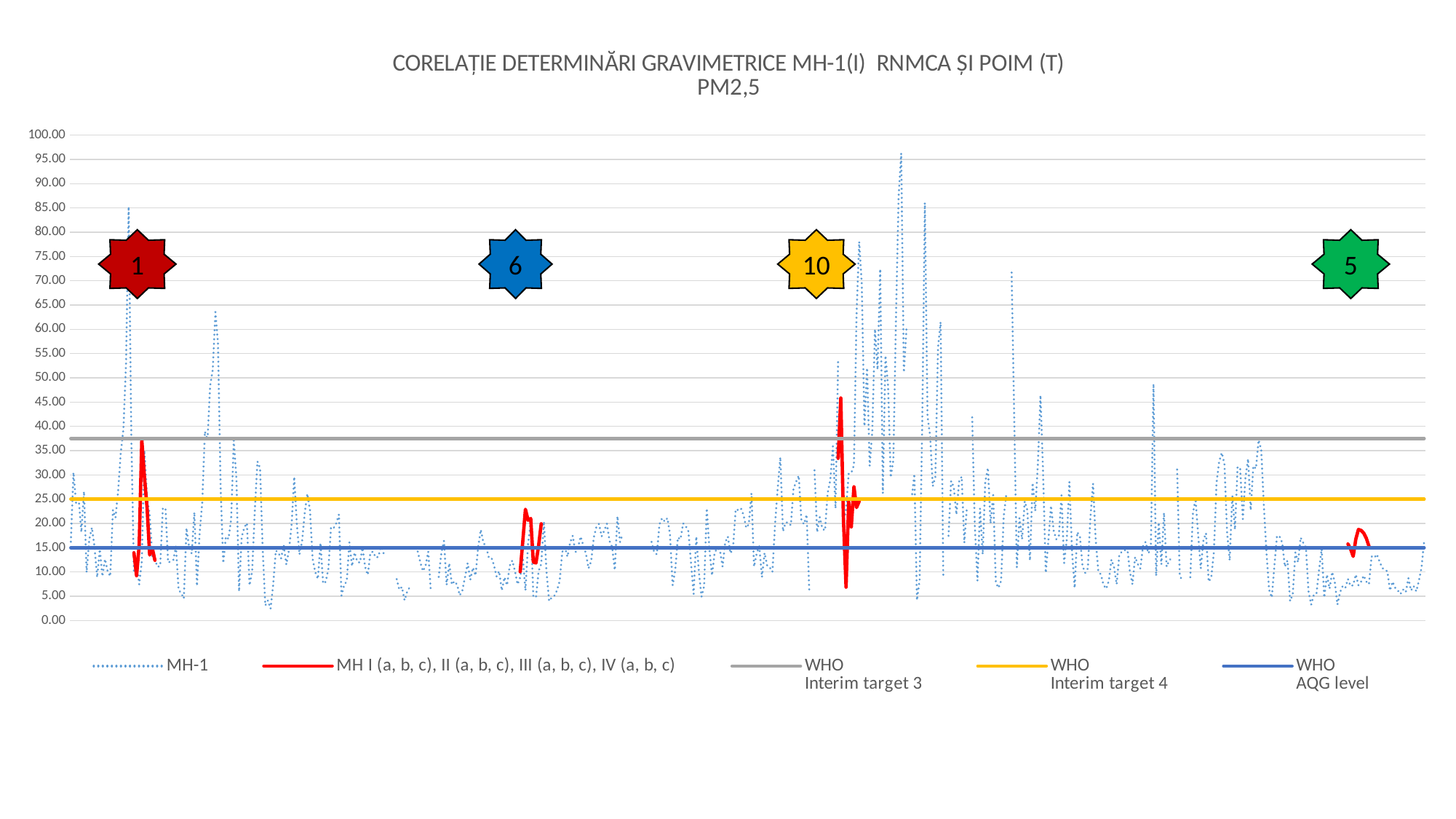
What is the title of the chart? CORELAȚIE DETERMINĂRI GRAVIMETRICE MH-1(I) RNMCA ȘI POIM (T) PM2,5 Is the WHO Interim target 3 line greater or less than 40? less What value does the WHO AQG level line sit at? 15.00 What value does the WHO Interim target 4 line sit at? 25.00 Which of the three WHO reference lines is the lowest? WHO AQG level Is the WHO Interim target 3 line greater or less than 35? greater How many series does the legend list? 5 Which is higher, the WHO Interim target 3 line or the WHO Interim target 4 line? WHO Interim target 3 What kind of chart is shown on the slide? line chart Which series reaches the highest value on the chart? MH-1 Which series is drawn as a dotted blue line? MH-1 Is the highest peak of the MH-1 series greater or less than 90? greater